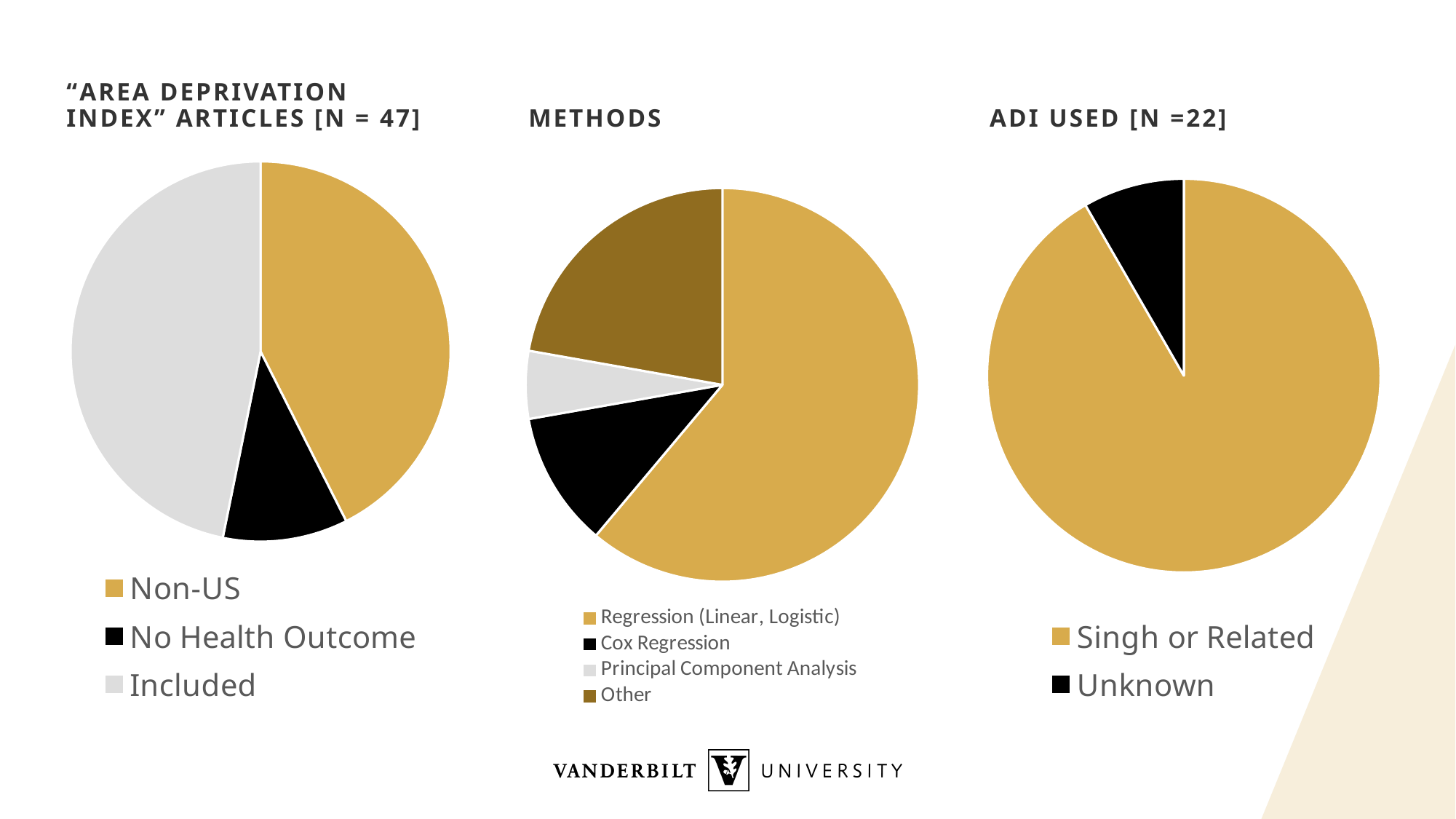
In the "ADI Used [N =22]" chart, what colour is the Unknown slice? black In the "ADI Used [N =22]" chart, how many slices does the pie have? 2 What is the N value given in the title of the rightmost pie chart? 22 In the "Area Deprivation Index" Articles [N = 47] chart, which category has the smallest slice? No Health Outcome In the "Methods" chart, which slice is larger: Other or Cox Regression? Other In the "Area Deprivation Index" Articles [N = 47] chart, how many slices does the pie have? 3 In the "Area Deprivation Index" Articles [N = 47] chart, which slice is larger: Included or No Health Outcome? Included In the "ADI Used [N =22]" chart, which category has the largest slice? Singh or Related What kind of chart is the "Methods" chart? pie chart In the "Methods" chart, which category has the smallest slice? Principal Component Analysis In the "Methods" chart, which category has the largest slice? Regression (Linear, Logistic) In the "Methods" chart, how many categories does the legend list? 4